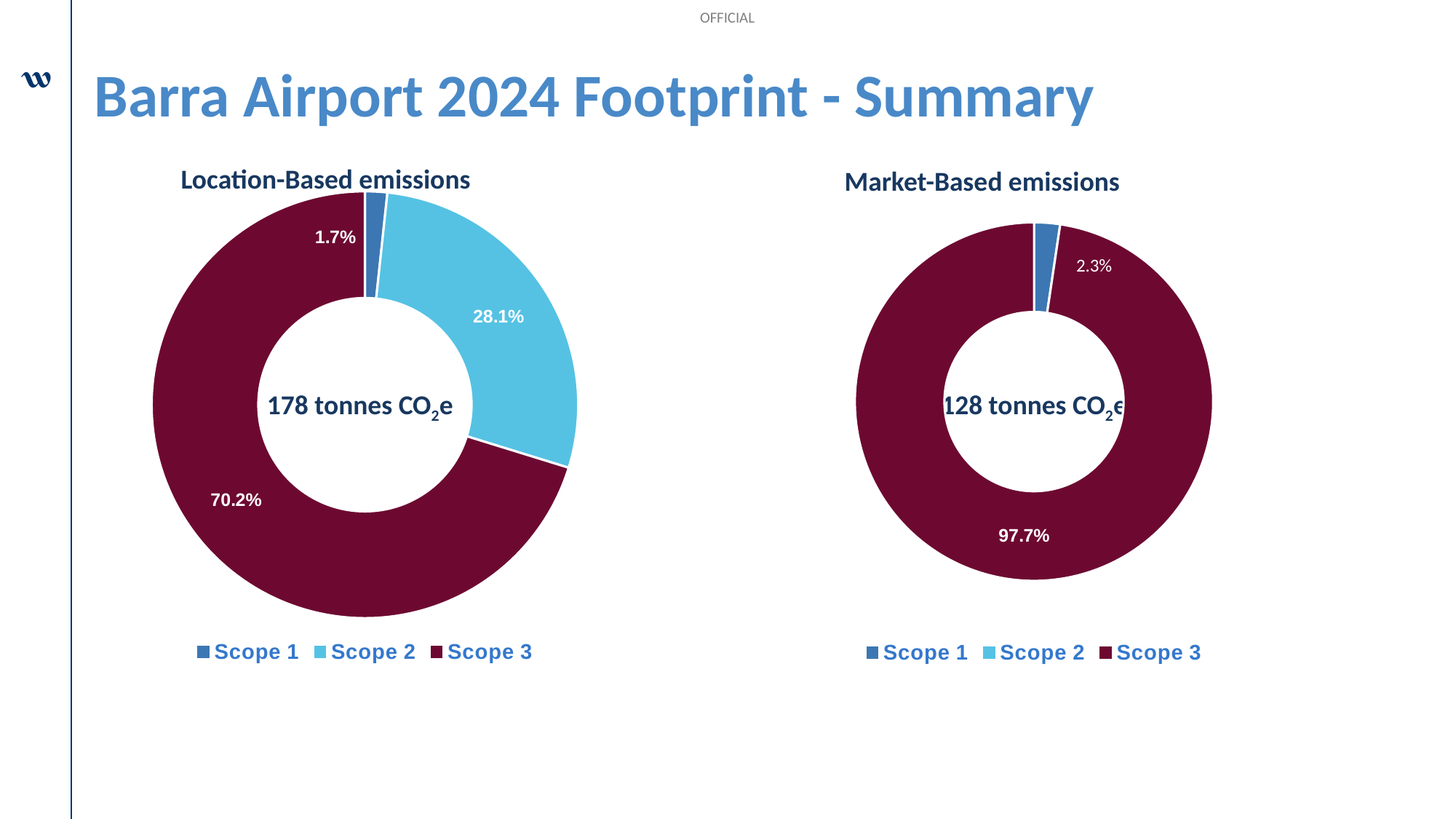
In the Market-Based emissions chart, which is larger, the Scope 1 share or the Scope 3 share? Scope 3 In the Location-Based emissions chart, which scope has the largest share? Scope 3 In the Market-Based emissions chart, what share of emissions is Scope 3? 97.7% In the Location-Based emissions chart, what share of emissions is Scope 3? 70.2% In the Location-Based emissions chart, what share of emissions is Scope 1? 1.7% What total is shown in the centre of the Market-Based emissions chart? 128 tonnes CO2e In the Location-Based emissions chart, what is the difference in percentage points between the Scope 3 and Scope 2 shares? 42.1 What total is shown in the centre of the Location-Based emissions chart? 178 tonnes CO2e In the Location-Based emissions chart, which scope has the smallest share? Scope 1 How many series does the legend of the Market-Based emissions chart list? 3